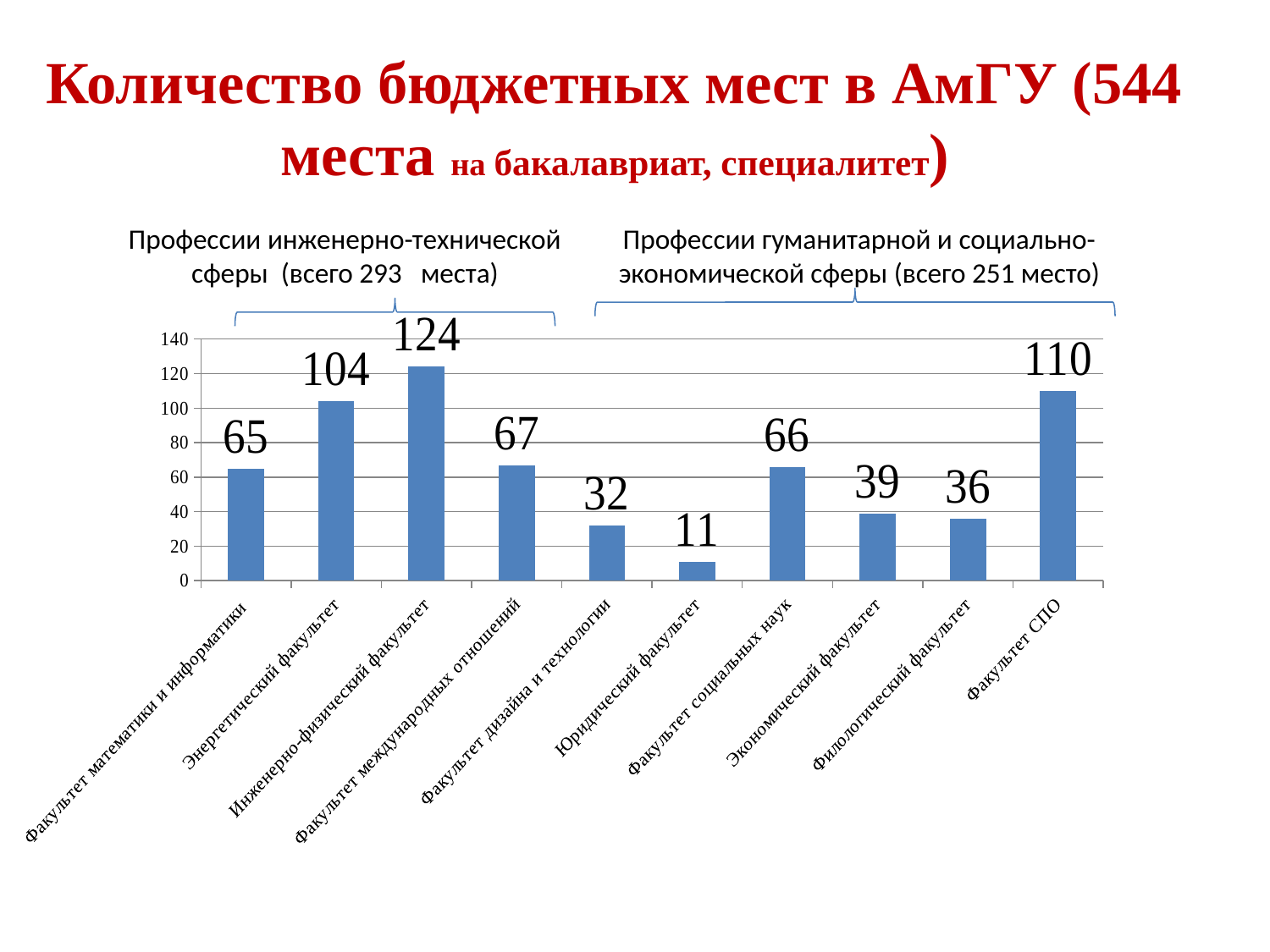
Which is larger: the value for Факультет социальных наук or the value for Факультет международных отношений? Факультет международных отношений How many faculties are shown on the chart? 10 Which faculty has the highest number of budget places? Инженерно-физический факультет What is the difference between the values for Факультет математики и информатики and Филологический факультет? 29 What kind of chart is shown on the slide? bar chart What is the value for Факультет СПО? 110 Which faculty has the lowest number of budget places? Юридический факультет What is the value for Экономический факультет? 39 Is the value for Факультет СПО greater or less than 100? greater What is the value for Инженерно-физический факультет? 124 What is the value for Юридический факультет? 11 What is the difference between the values for Инженерно-физический факультет and Энергетический факультет? 20